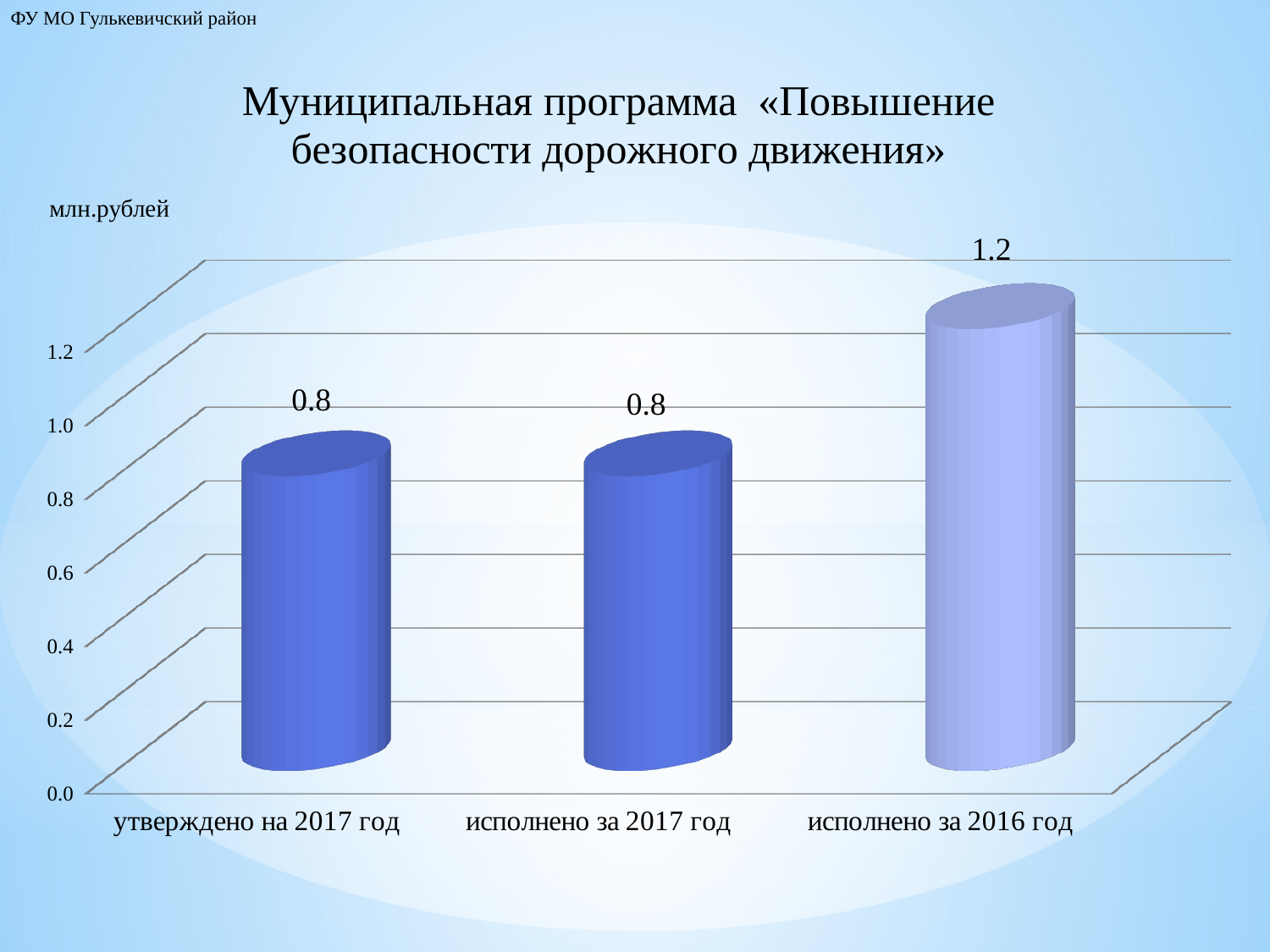
Which is larger: the value for «исполнено за 2016 год» or the value for «утверждено на 2017 год»? исполнено за 2016 год What is the value for «исполнено за 2017 год»? 0.8 What is the value for «исполнено за 2016 год»? 1.2 Is the value for «исполнено за 2016 год» greater or less than 1.0? greater What is the difference between the value for «исполнено за 2016 год» and the value for «исполнено за 2017 год»? 0.4 What is the value for «утверждено на 2017 год»? 0.8 What unit of measurement is indicated above the chart? млн.рублей What is the title of the slide? Муниципальная программа «Повышение безопасности дорожного движения» Which category has the highest value? исполнено за 2016 год Is the value for «утверждено на 2017 год» greater or less than 1.0? less What kind of chart is shown on the slide? bar chart How many categories are shown on the chart? 3